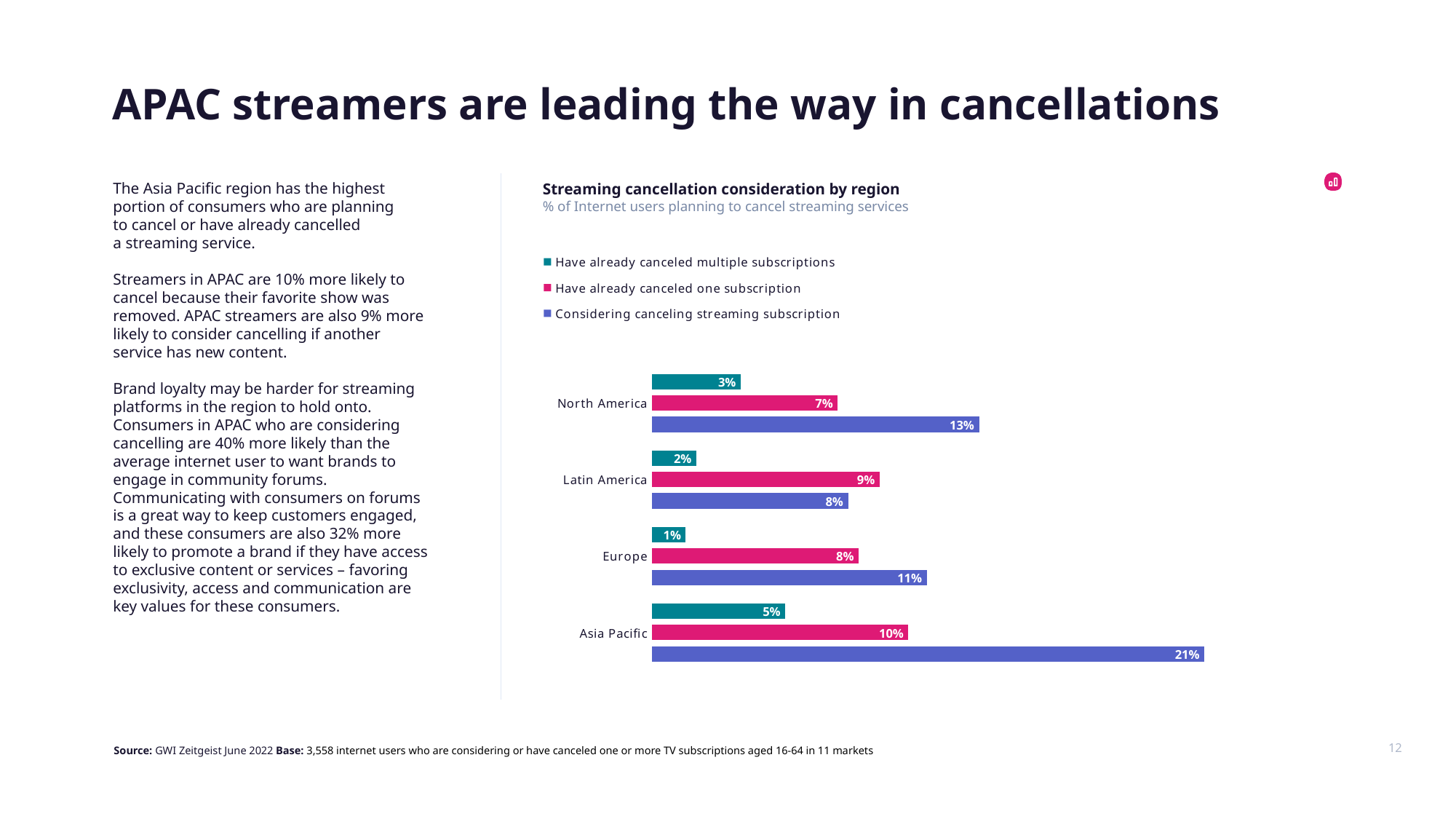
How many series does the legend list? 3 Which is larger: the percentage in Latin America who have already canceled one subscription, or the percentage in Europe who have already canceled one subscription? Latin America How many regions are shown in the chart? 4 What percentage of Internet users in Asia Pacific are considering canceling a streaming subscription? 21% What type of chart is shown on the slide? Bar chart Which region has the lowest percentage of Internet users who have already canceled multiple subscriptions? Europe What percentage of Internet users in Europe have already canceled multiple subscriptions? 1% What percentage of Internet users in Latin America are considering canceling a streaming subscription? 8% What percentage of Internet users in North America have already canceled one subscription? 7% What is the title of the chart? Streaming cancellation consideration by region What is the difference between Asia Pacific and North America in the percentage considering canceling a streaming subscription? 8% Which region has the highest percentage of Internet users considering canceling a streaming subscription? Asia Pacific